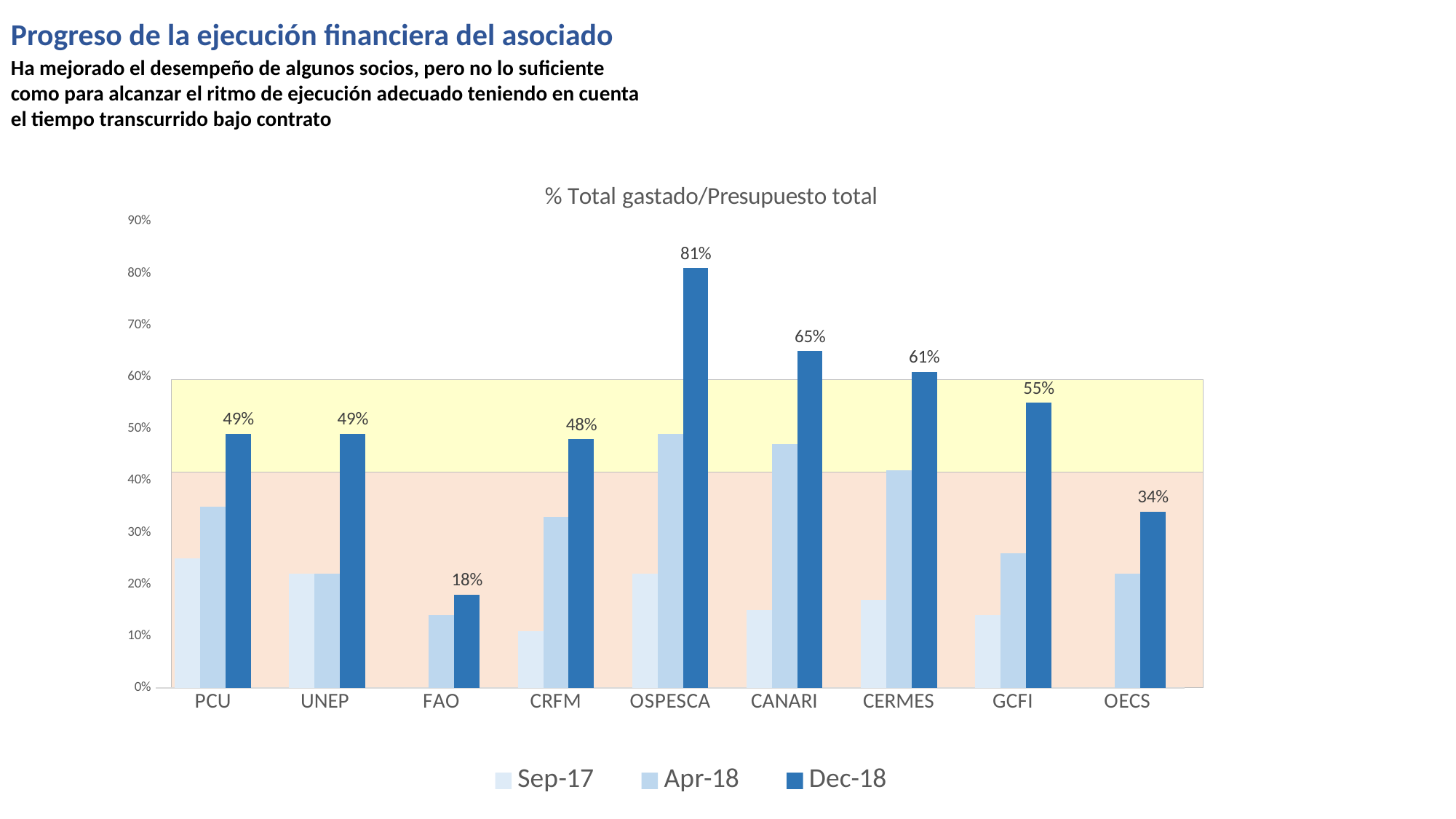
What is the Dec-18 value for OECS? 34% Which partner has the highest Dec-18 value? OSPESCA How many partners are shown on the x axis? 9 Is the Apr-18 value for CERMES greater or less than 50%? less Which has a larger Dec-18 value, CERMES or GCFI? CERMES What is the difference between the Dec-18 values for OSPESCA and CANARI? 16% What kind of chart is shown on the slide? Bar chart Is the Sep-17 value for PCU greater or less than 20%? greater What is the Dec-18 value for OSPESCA? 81% How many series does the legend list? 3 What is the Dec-18 value for FAO? 18% Which partner has the lowest Dec-18 value? FAO